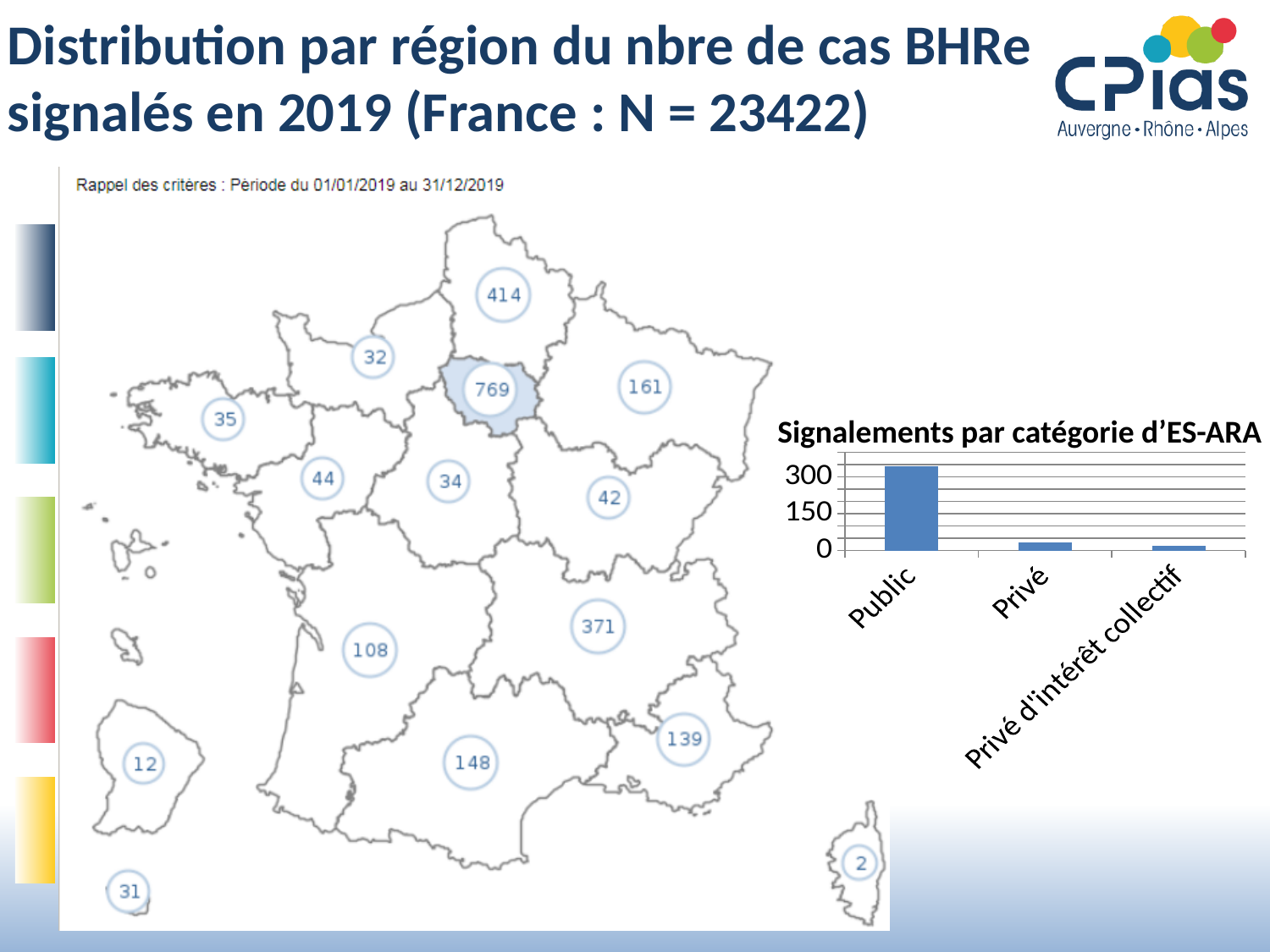
In the "Signalements par catégorie d'ES-ARA" chart, is the value for Public greater or less than 300? greater What is the highest tick value shown on the y axis of the "Signalements par catégorie d'ES-ARA" chart? 300 In the "Signalements par catégorie d'ES-ARA" chart, which category has the lowest value? Privé d'intérêt collectif In the "Signalements par catégorie d'ES-ARA" chart, is the value for Privé greater or less than 150? less In the "Signalements par catégorie d'ES-ARA" chart, which is larger: Privé or Privé d'intérêt collectif? Privé What is the title of the bar chart on the slide? Signalements par catégorie d'ES-ARA What kind of chart is "Signalements par catégorie d'ES-ARA"? bar chart In the "Signalements par catégorie d'ES-ARA" chart, which is larger: Public or Privé? Public In the "Signalements par catégorie d'ES-ARA" chart, is the value for Privé d'intérêt collectif greater or less than 150? less How many categories are shown on the x axis of the "Signalements par catégorie d'ES-ARA" chart? 3 Do the values in the "Signalements par catégorie d'ES-ARA" chart rise or fall from left to right along the x axis? fall In the "Signalements par catégorie d'ES-ARA" chart, which category has the highest value? Public